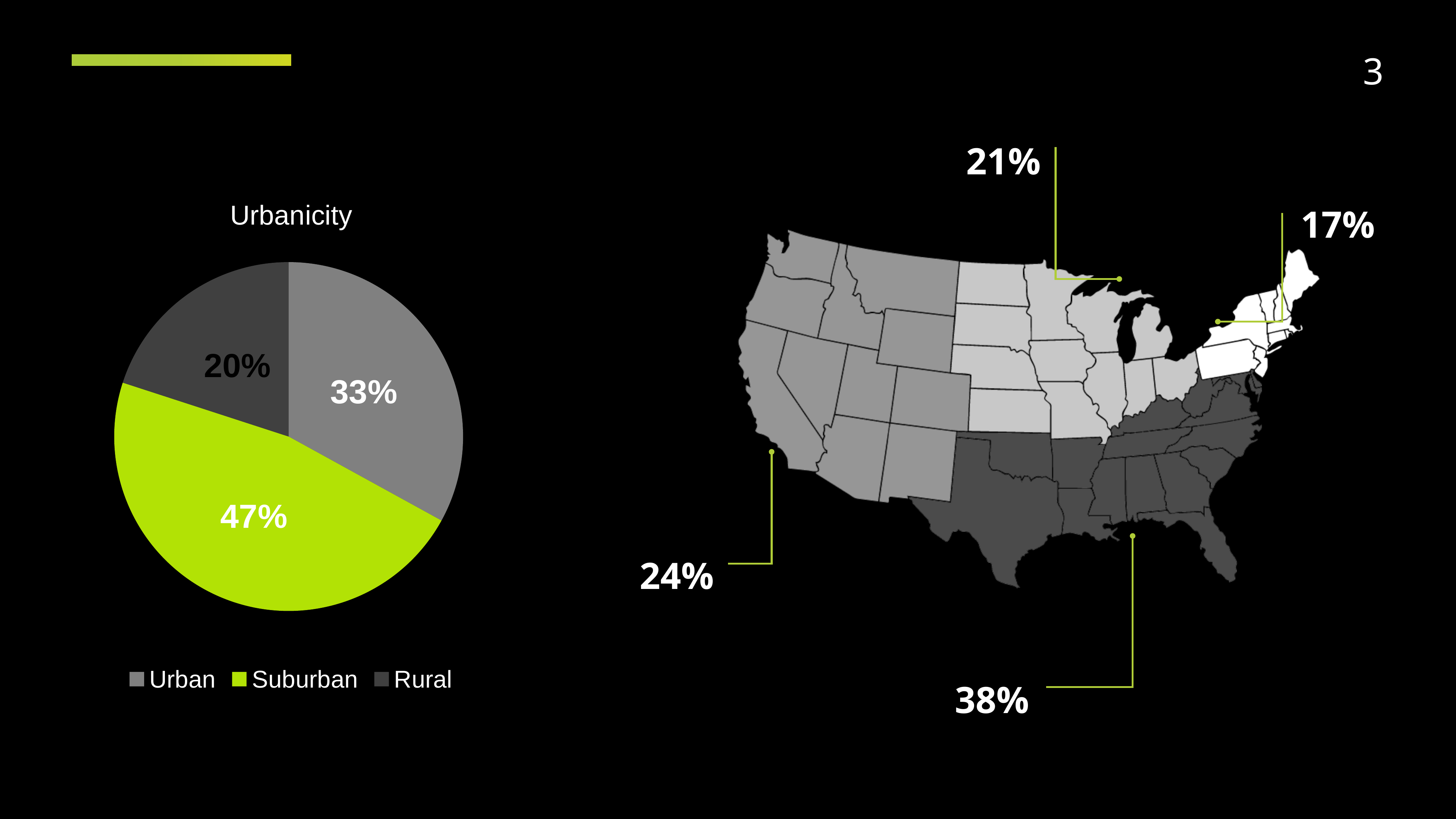
In the Urbanicity pie chart, which is larger, Urban or Rural? Urban What type of chart is the Urbanicity chart? Pie chart In the Urbanicity pie chart, what percentage is Rural? 20% In the Urbanicity pie chart, what is the difference in percentage points between Suburban and Urban? 14 How many slices does the Urbanicity pie chart have? 3 On the US map on the right, what is the highest percentage shown? 38% In the Urbanicity pie chart, what percentage is Urban? 33% In the Urbanicity pie chart, which category is shown in green? Suburban In the Urbanicity pie chart, what percentage is Suburban? 47% In the Urbanicity pie chart, which category has the largest share? Suburban On the US map on the right, what is the lowest percentage shown? 17% In the Urbanicity pie chart, which category has the smallest share? Rural